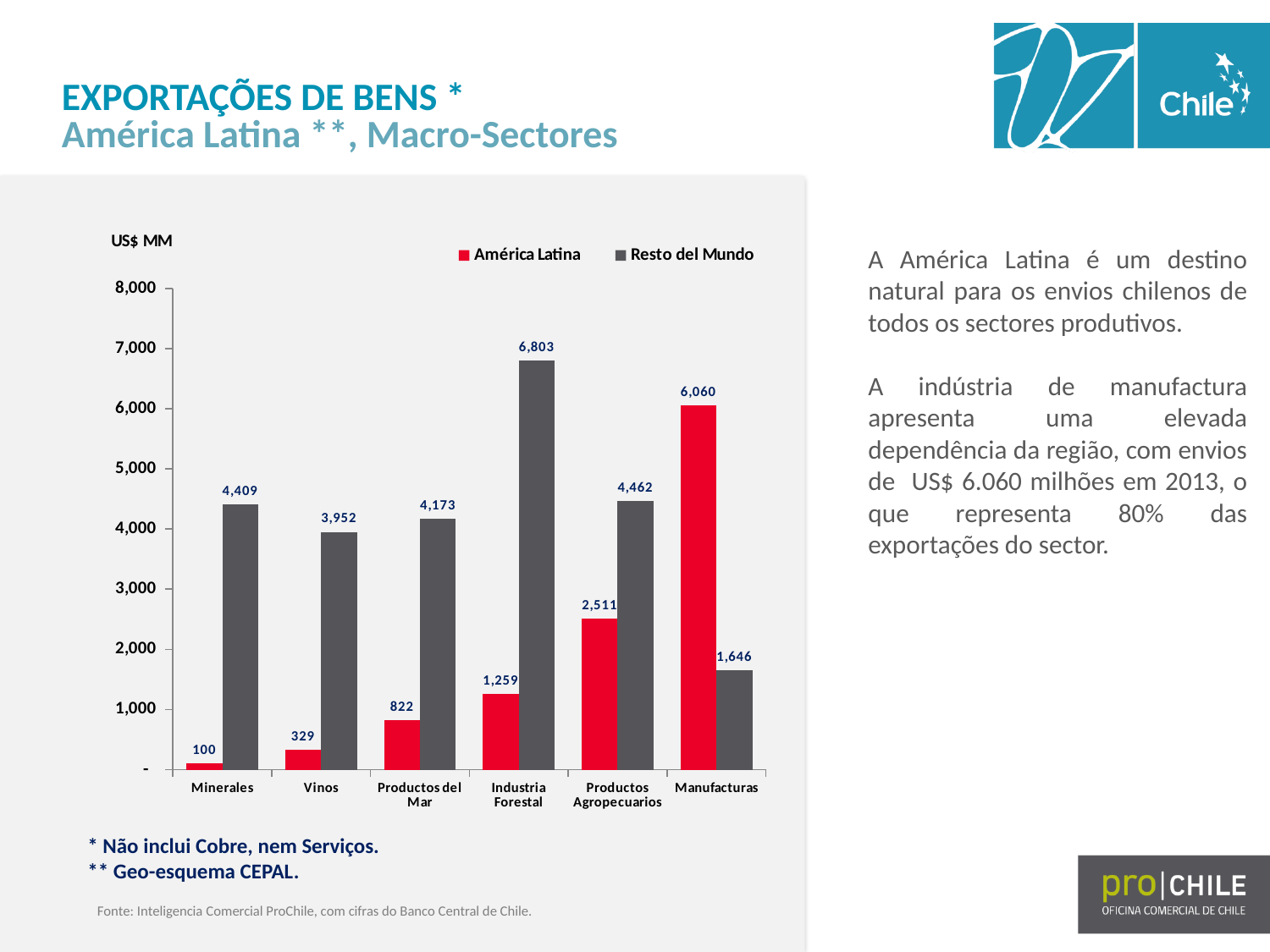
Which is larger for Productos del Mar: América Latina or Resto del Mundo? Resto del Mundo Which category has the highest América Latina value? Manufacturas What is the América Latina value for Manufacturas? 6,060 How many categories are shown on the x axis? 6 What kind of chart is shown on the slide? Bar chart What is the Resto del Mundo value for Vinos? 3,952 How many series does the legend list? 2 What is the difference between the Resto del Mundo and América Latina values for Productos Agropecuarios? 1,951 Which category has the lowest Resto del Mundo value? Manufacturas What is the América Latina value for Minerales? 100 What unit is shown above the y axis of the chart? US$ MM What is the Resto del Mundo value for Industria Forestal? 6,803